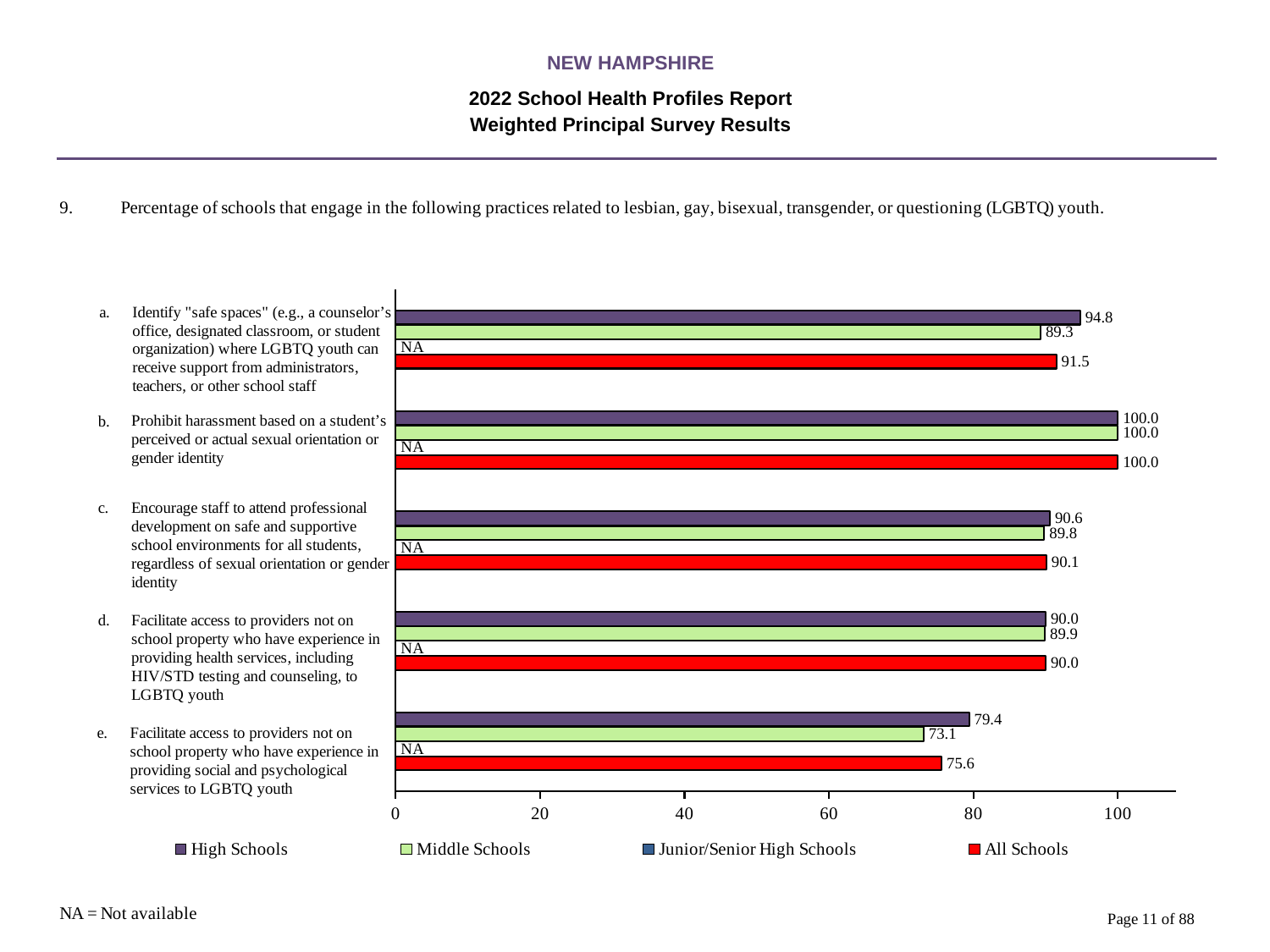
How many practices (categories) are shown on the chart? 5 What kind of chart is shown on the slide? bar chart What is the value for All Schools for practice e (facilitate access to providers of social and psychological services)? 75.6 What is the value for High Schools for practice a (identify "safe spaces")? 94.8 For practice e, which is larger: the High Schools value or the All Schools value? High Schools Which practice has the highest value for All Schools? b. Prohibit harassment based on a student's perceived or actual sexual orientation or gender identity How many series does the legend list? 4 What is the difference between the High Schools and Middle Schools values for practice e? 6.3 Which practice has the lowest value for Middle Schools? e. Facilitate access to providers not on school property who have experience in providing social and psychological services to LGBTQ youth What is the value for Middle Schools for practice c (encourage staff to attend professional development)? 89.8 Is the Middle Schools value for practice e greater or less than 80? less What is the difference between the High Schools and All Schools values for practice a? 3.3